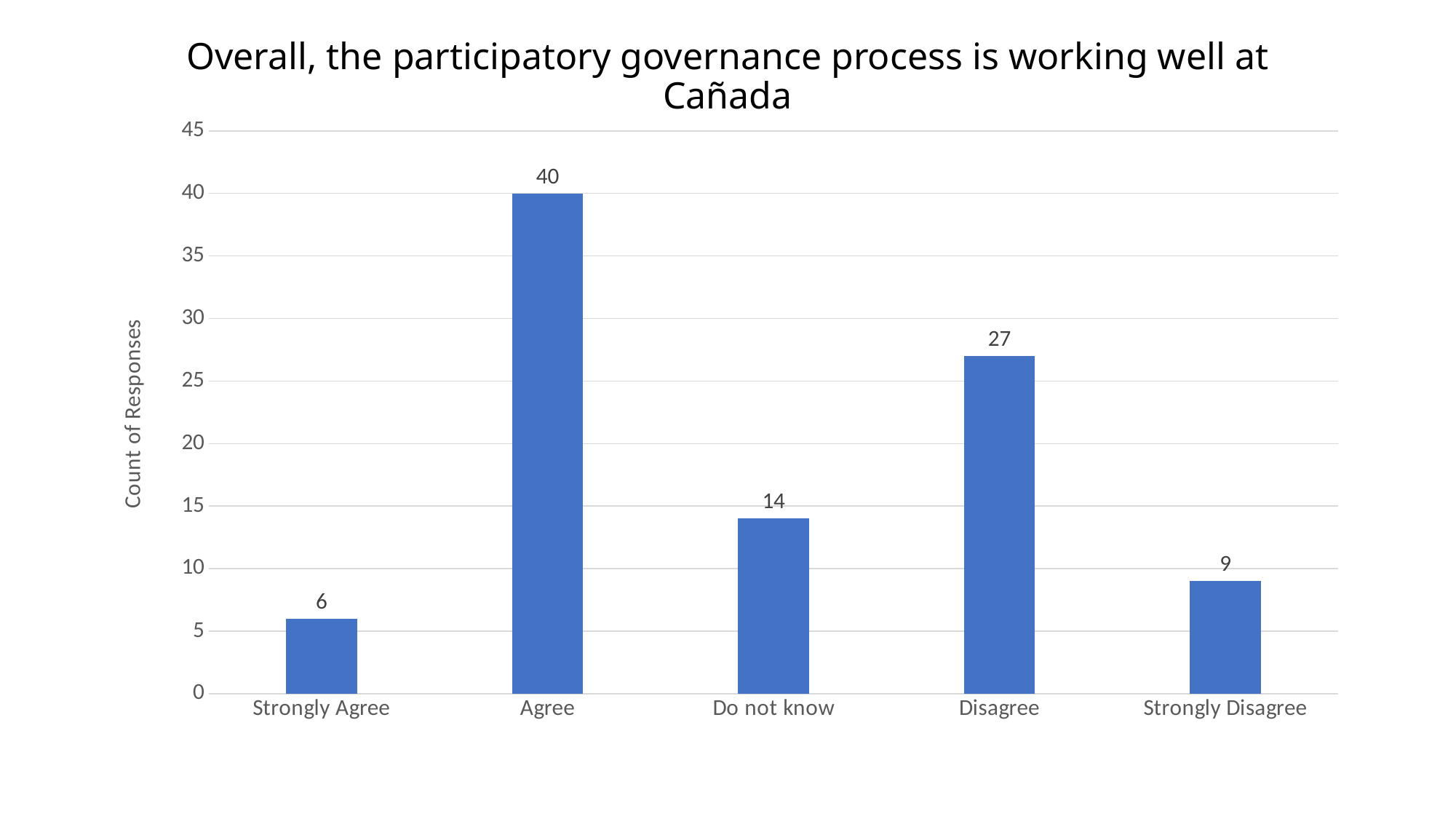
Which has a higher count, Do not know or Strongly Disagree? Do not know What kind of chart is shown on the slide? Bar chart How many response categories are shown on the x axis? 5 What is the count of responses for Strongly Disagree? 9 Which response category has the lowest count? Strongly Agree What is the count of responses for Do not know? 14 What is the difference between the counts for Agree and Disagree? 13 Which response category has the highest count? Agree What is the count of responses for Strongly Agree? 6 What is the label of the vertical axis? Count of Responses Is the value for Disagree greater or less than 25? greater What is the count of responses for Agree? 40